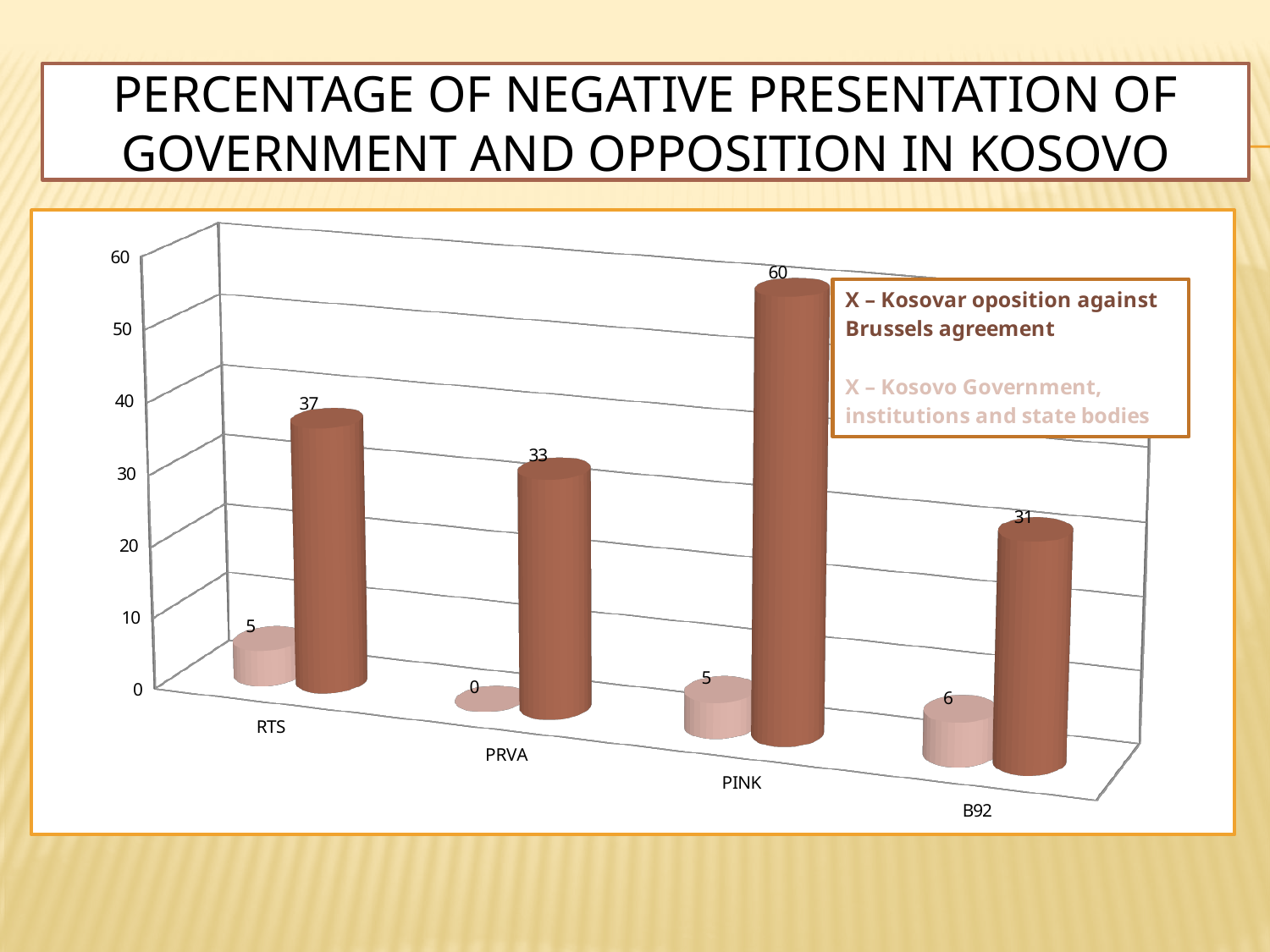
What is the value for B92 for the Kosovar opposition against Brussels agreement series? 31 What is the difference between the Kosovar opposition values for PINK and RTS? 23 Which category has the highest value for the Kosovar opposition against Brussels agreement series? PINK Which category has the lowest value for the Kosovo Government, institutions and state bodies series? PRVA What is the value for PRVA for the Kosovo Government, institutions and state bodies series? 0 What is the title of the slide? Percentage of negative presentation of government and opposition in Kosovo What is the value for PINK for the Kosovar opposition against Brussels agreement series? 60 How many series does the legend list? 2 How many categories are shown on the x axis? 4 What is the value for RTS for the Kosovo Government, institutions and state bodies series? 5 What kind of chart is shown on the slide? Bar chart Which is larger for the Kosovar opposition against Brussels agreement series: RTS or PRVA? RTS